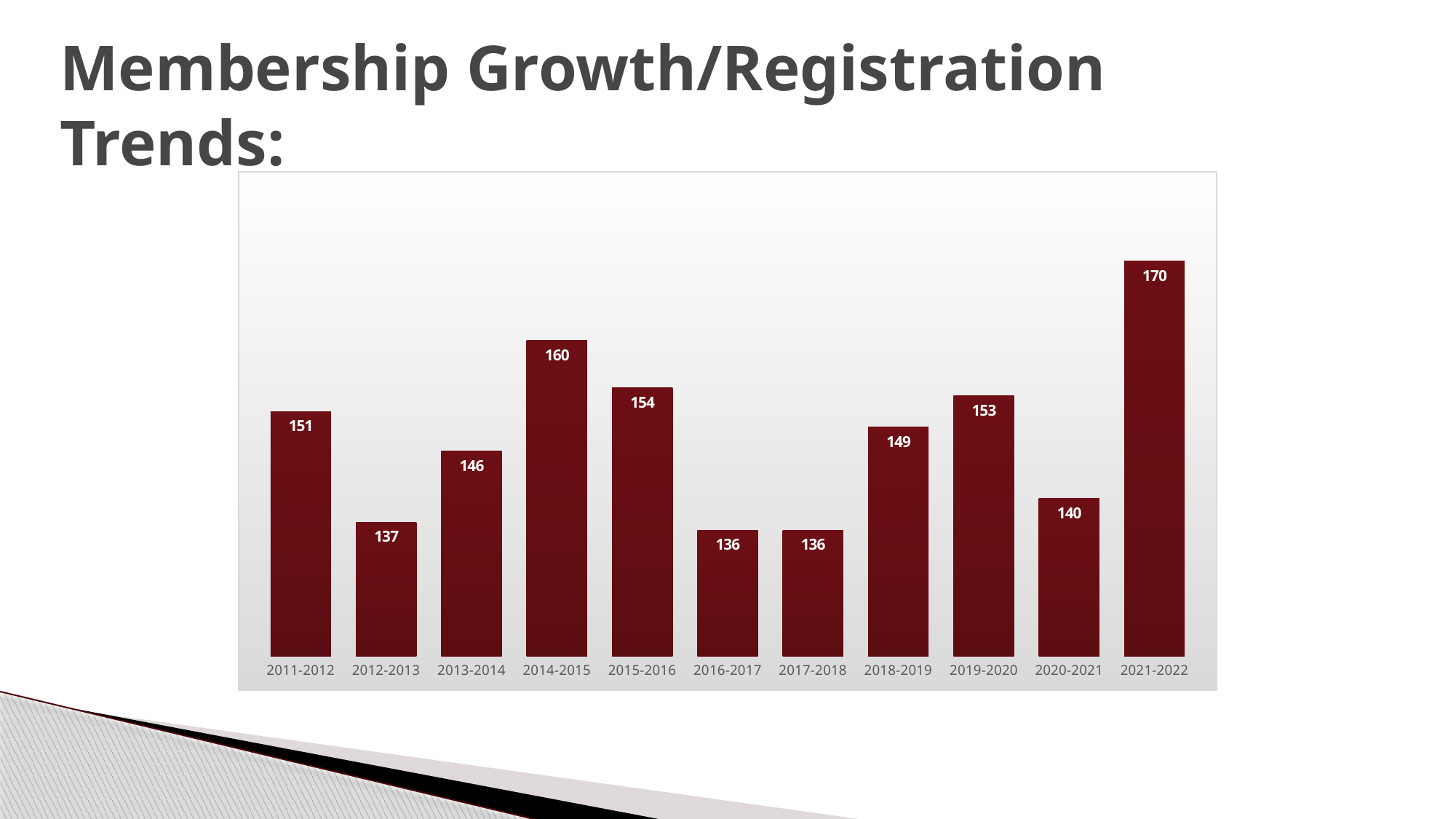
What is the value for 2020-2021? 140 Which year has the highest value? 2021-2022 Which years share the lowest value? 2016-2017 and 2017-2018 What is the difference between the values for 2021-2022 and 2020-2021? 30 Which is larger, the value for 2015-2016 or the value for 2019-2020? 2015-2016 Do the values rise or fall from 2017-2018 to 2019-2020? Rise What kind of chart is shown on the slide? Bar chart Which is larger, the value for 2013-2014 or the value for 2018-2019? 2018-2019 How many years are shown on the x axis? 11 What is the difference between the values for 2014-2015 and 2012-2013? 23 What is the value for 2014-2015? 160 What is the value for 2011-2012? 151